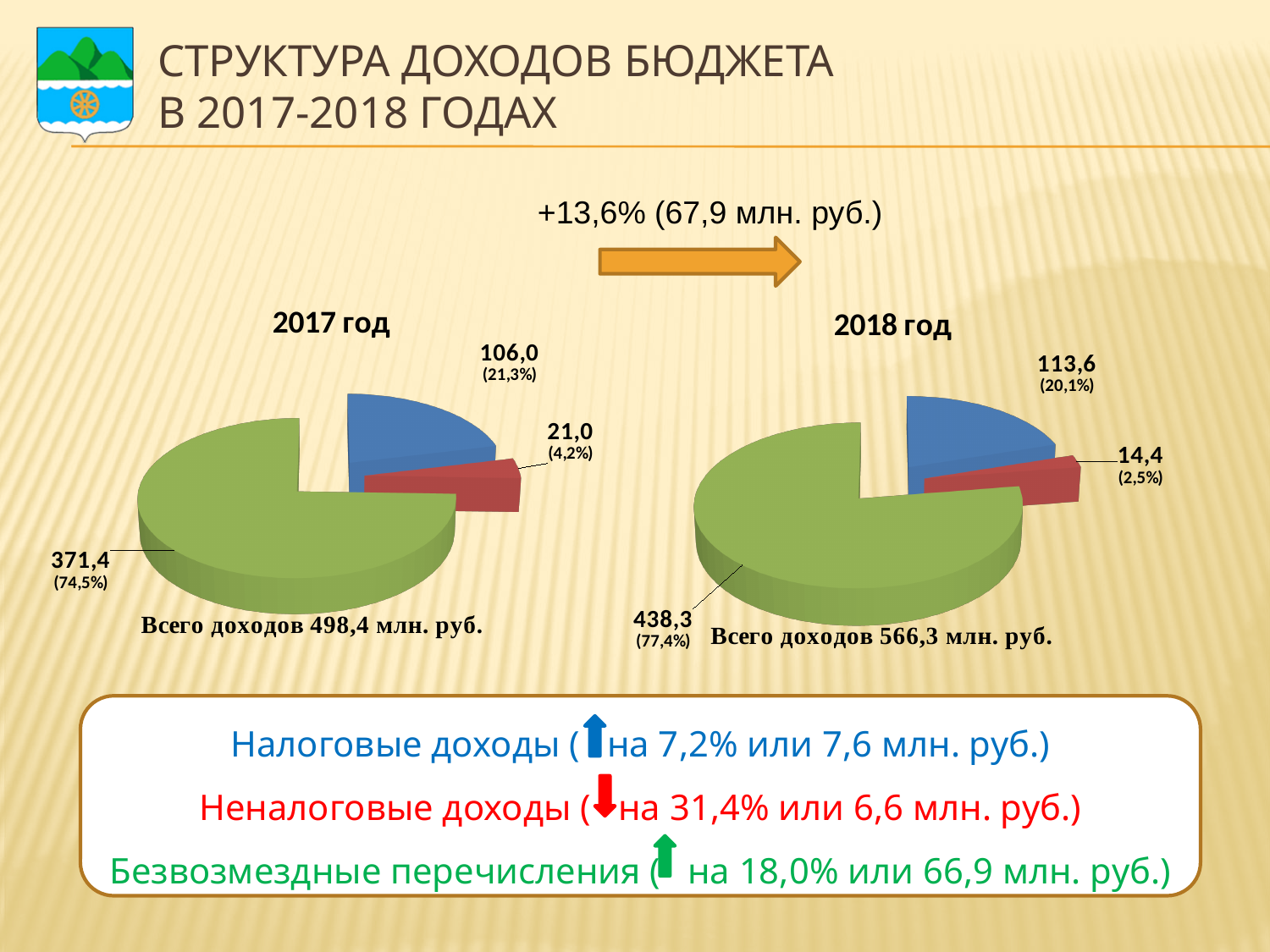
In the "2018 год" pie chart, what is the value of the smallest (red) slice? 14,4 What kind of charts are shown on the slide? Pie charts In the "2017 год" pie chart, what is the value of the red slice? 21,0 In the "2018 год" pie chart, what is the value of the blue slice? 113,6 In the "2018 год" pie chart, what share of the pie does the blue slice represent? 20,1% What is the total income shown for the "2017 год" pie chart? 498,4 млн. руб. What is the total income shown for the "2018 год" pie chart? 566,3 млн. руб. In the "2017 год" pie chart, what share of the pie does the largest slice represent? 74,5% In the "2017 год" pie chart, what is the value of the largest (green) slice? 371,4 What is the difference between the green slice in the "2018 год" chart (438,3) and the green slice in the "2017 год" chart (371,4)? 66,9 Which is larger: the blue slice in the "2017 год" chart or the blue slice in the "2018 год" chart? 2018 год (113,6) How many slices does the "2017 год" pie chart have? 3